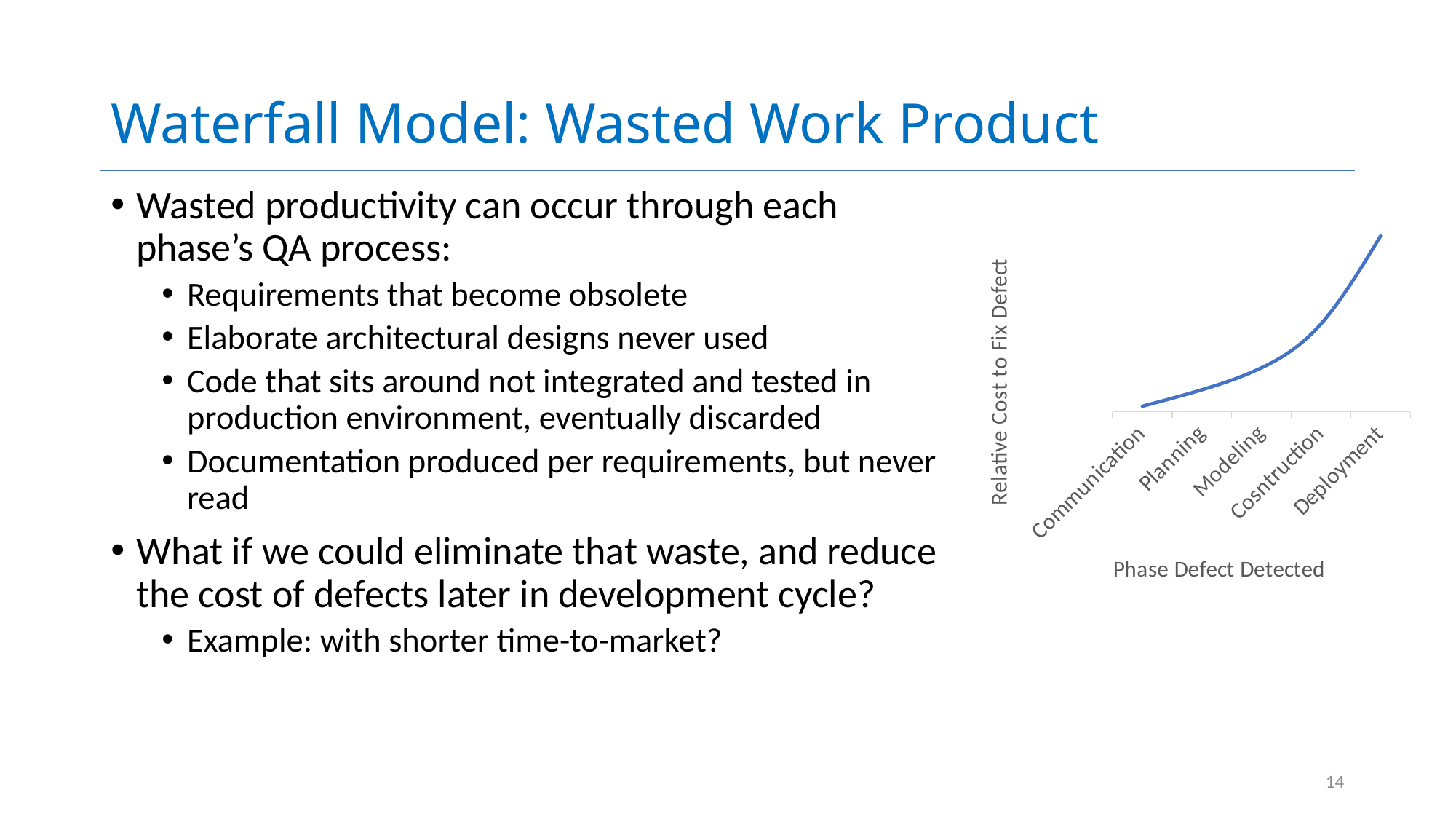
How many phases are listed along the x axis of the chart? 5 What kind of chart is shown on the slide? line chart Does the relative cost to fix a defect rise or fall as the phases move from Communication to Deployment? rise Which phase comes immediately after Modeling on the chart's x axis? Construction Which phase has the highest relative cost to fix a defect in the chart? Deployment Which phase has the lowest relative cost to fix a defect in the chart? Communication Which phase has a higher relative cost to fix a defect, Deployment or Modeling? Deployment What is the title of the chart's y axis? Relative Cost to Fix Defect What is the title of the chart's x axis? Phase Defect Detected Which phase has a higher relative cost to fix a defect, Planning or Construction? Construction